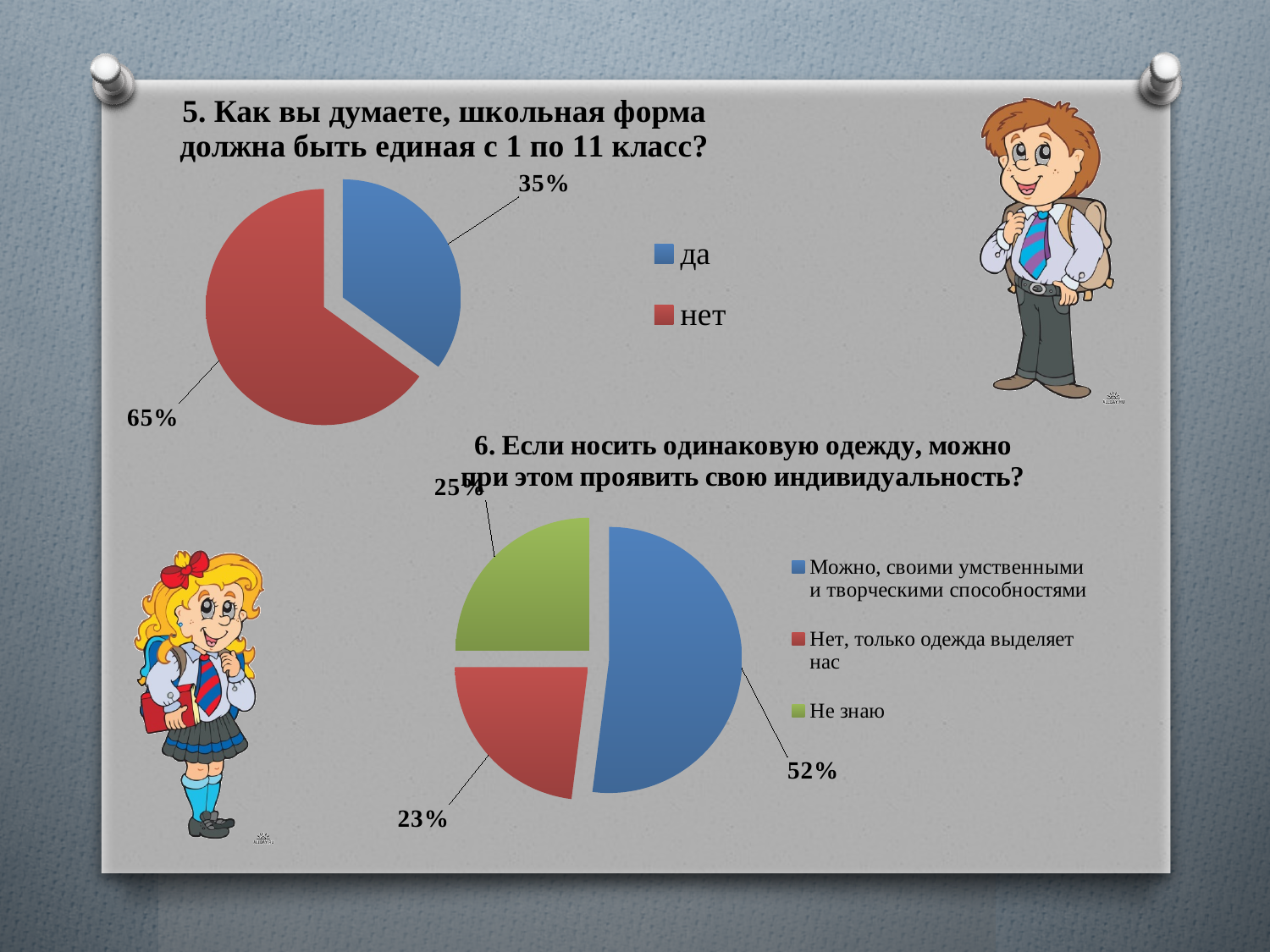
In the top pie chart (question 5), what share of respondents answered "нет"? 65% In the top pie chart (question 5), which answer has the largest share? нет In the bottom pie chart (question 6), what share answered "Нет, только одежда выделяет нас"? 23% In the top pie chart (question 5 about a single school uniform from grades 1 to 11), what share of respondents answered "да"? 35% In the bottom pie chart (question 6), which answer has the smallest share? Нет, только одежда выделяет нас In the bottom pie chart (question 6 about showing individuality in identical clothing), what share answered "Можно, своими умственными и творческими способностями"? 52% In the bottom pie chart (question 6), what colour is the slice for "Не знаю"? Green What type of chart is used for question 5 at the top of the slide? Pie chart In the top pie chart (question 5), what is the difference between the "нет" and "да" shares? 30% In the bottom pie chart (question 6), what share answered "Не знаю"? 25% How many entries does the legend of the top pie chart (question 5) list? 2 How many slices does the bottom pie chart (question 6) have? 3